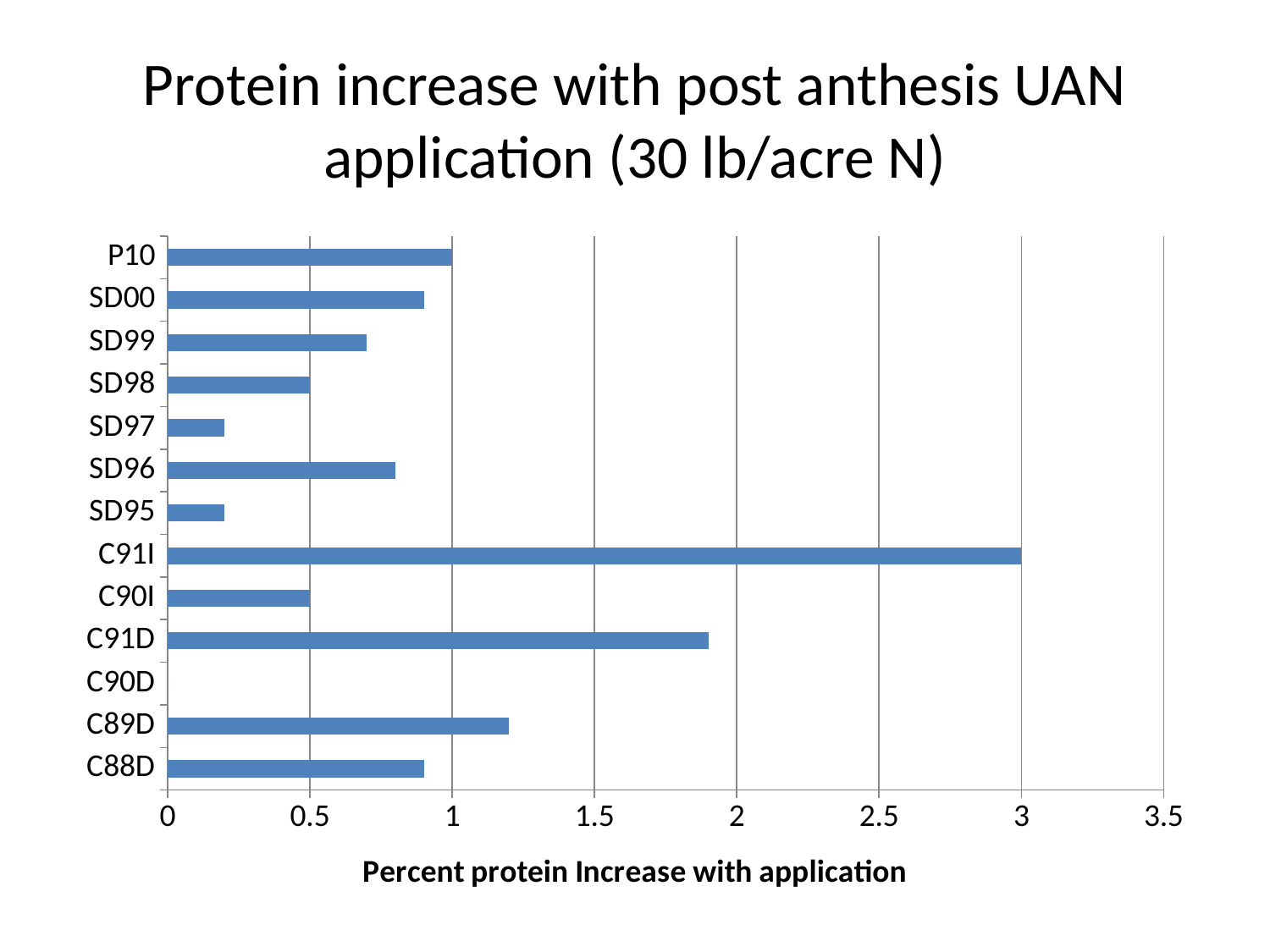
Is the value for C91D greater or less than 1.5? greater Which category has the highest percent protein increase? C91I Is the value for C89D greater or less than 1? greater Which has a larger percent protein increase, SD96 or SD95? SD96 Which category has the lowest percent protein increase? C90D What is the percent protein increase for C91I? 3 Is the value for SD97 greater or less than 0.5? less What is the title of the horizontal axis? Percent protein Increase with application What is the percent protein increase for P10? 1 What is the percent protein increase for SD98? 0.5 What kind of chart is shown on the slide? bar chart How many categories are plotted on the chart? 13